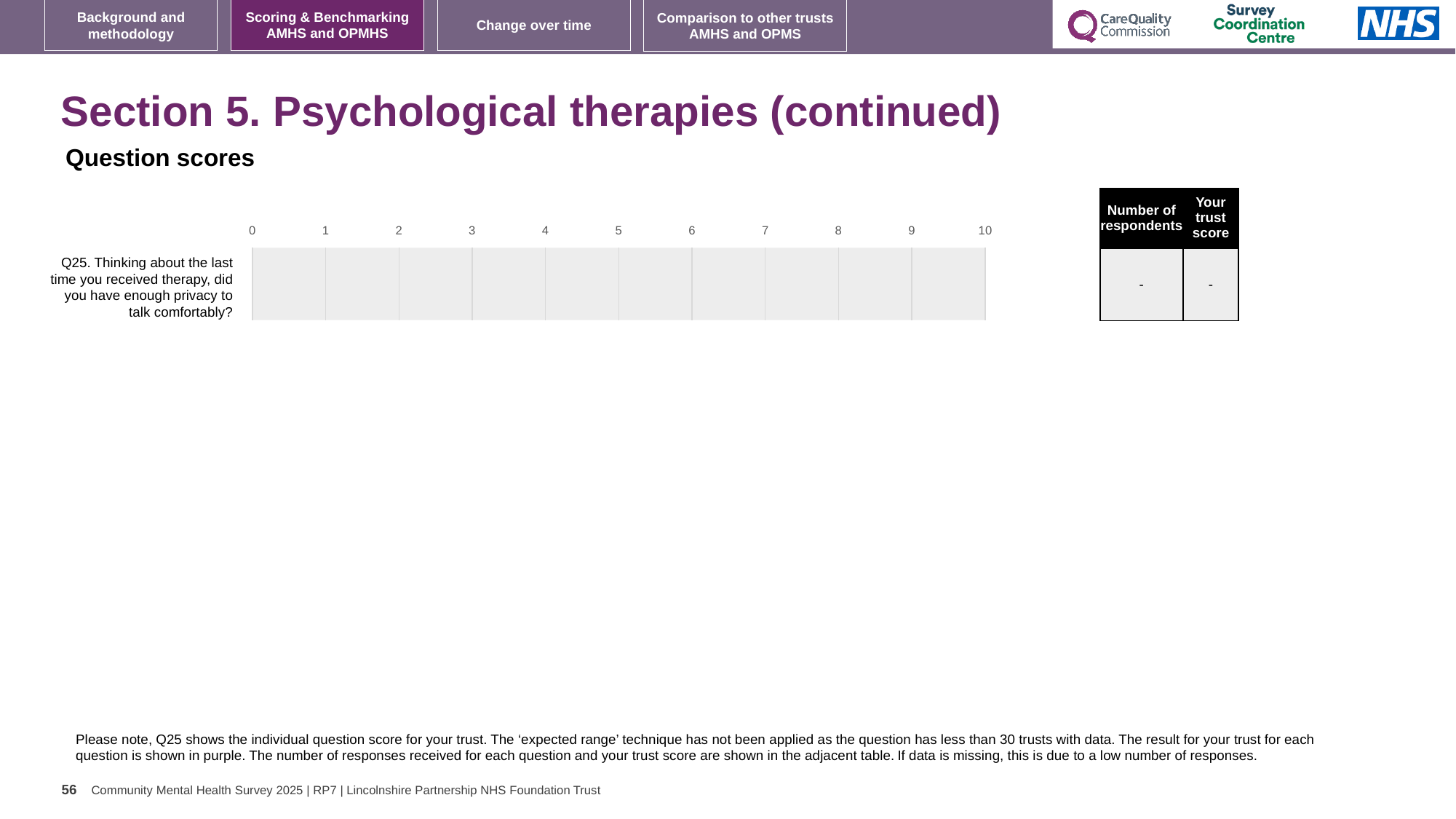
How many questions (categories) are plotted on the chart? 1 What is the lowest value shown on the chart's axis? 0 What kind of chart is shown on the slide? bar chart What is the 'Your trust score' value shown in the table for Q25? - What is the 'Number of respondents' value shown in the table for Q25? - Is a bar plotted for Q25 on the chart? No Which question number is plotted on the chart? Q25 What is the highest value shown on the chart's axis? 10